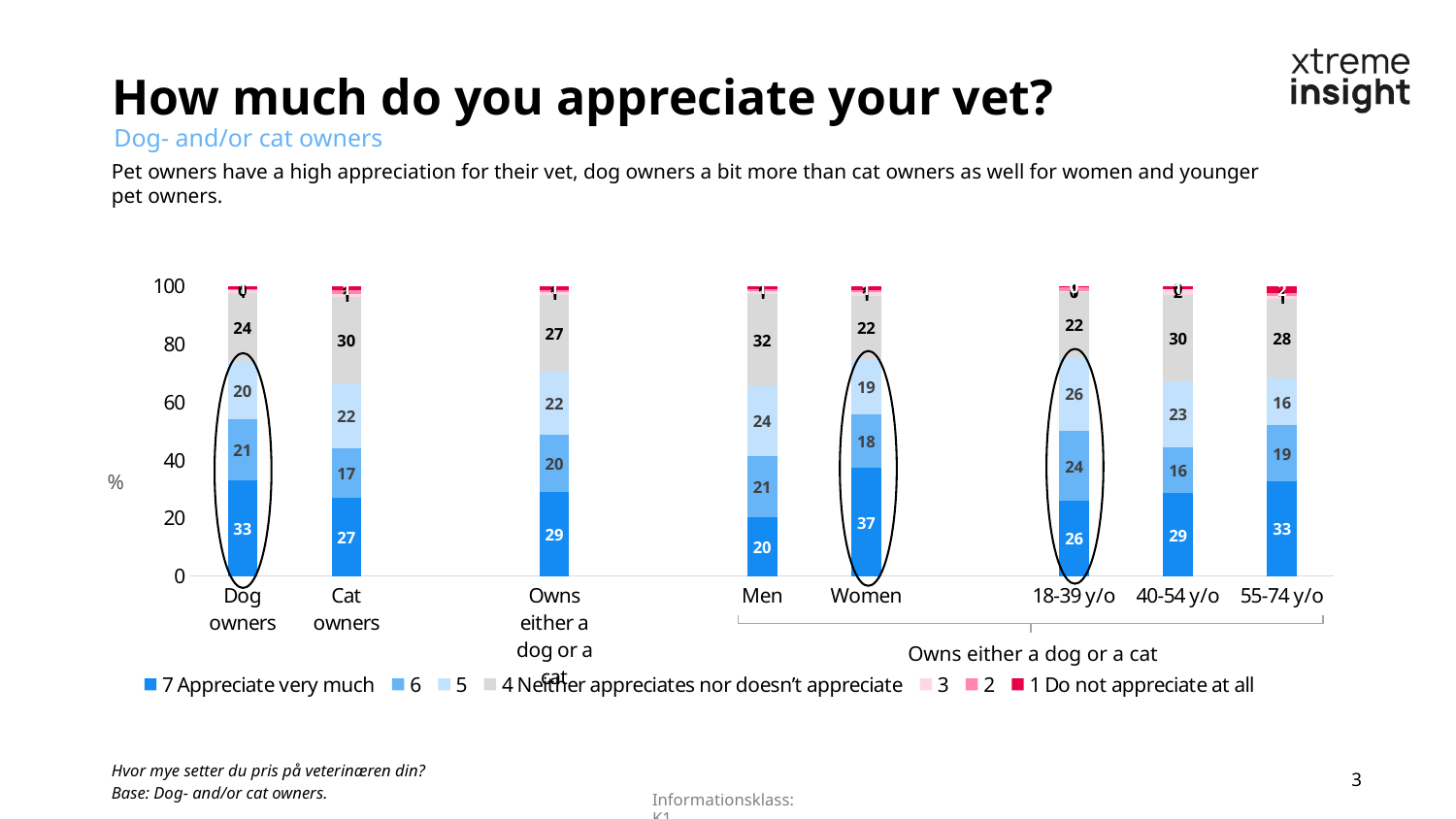
What is the value of the "5" segment for cat owners? 22 What is the value of the "6" segment for the 18-39 y/o group? 24 What kind of chart is shown on the slide? Stacked bar chart Which has a larger "7 Appreciate very much" value, dog owners or cat owners? Dog owners What percentage of dog owners answered "7 Appreciate very much"? 33 What is the value for "4 Neither appreciates nor doesn't appreciate" among men? 32 What is the title of the slide's chart? How much do you appreciate your vet? How many series does the legend list? 7 How many categories are shown on the x axis of the chart? 8 What is the difference between women and men in the "7 Appreciate very much" segment? 17 Which category has the highest value for "7 Appreciate very much"? Women Which category has the lowest value for "7 Appreciate very much"? Men